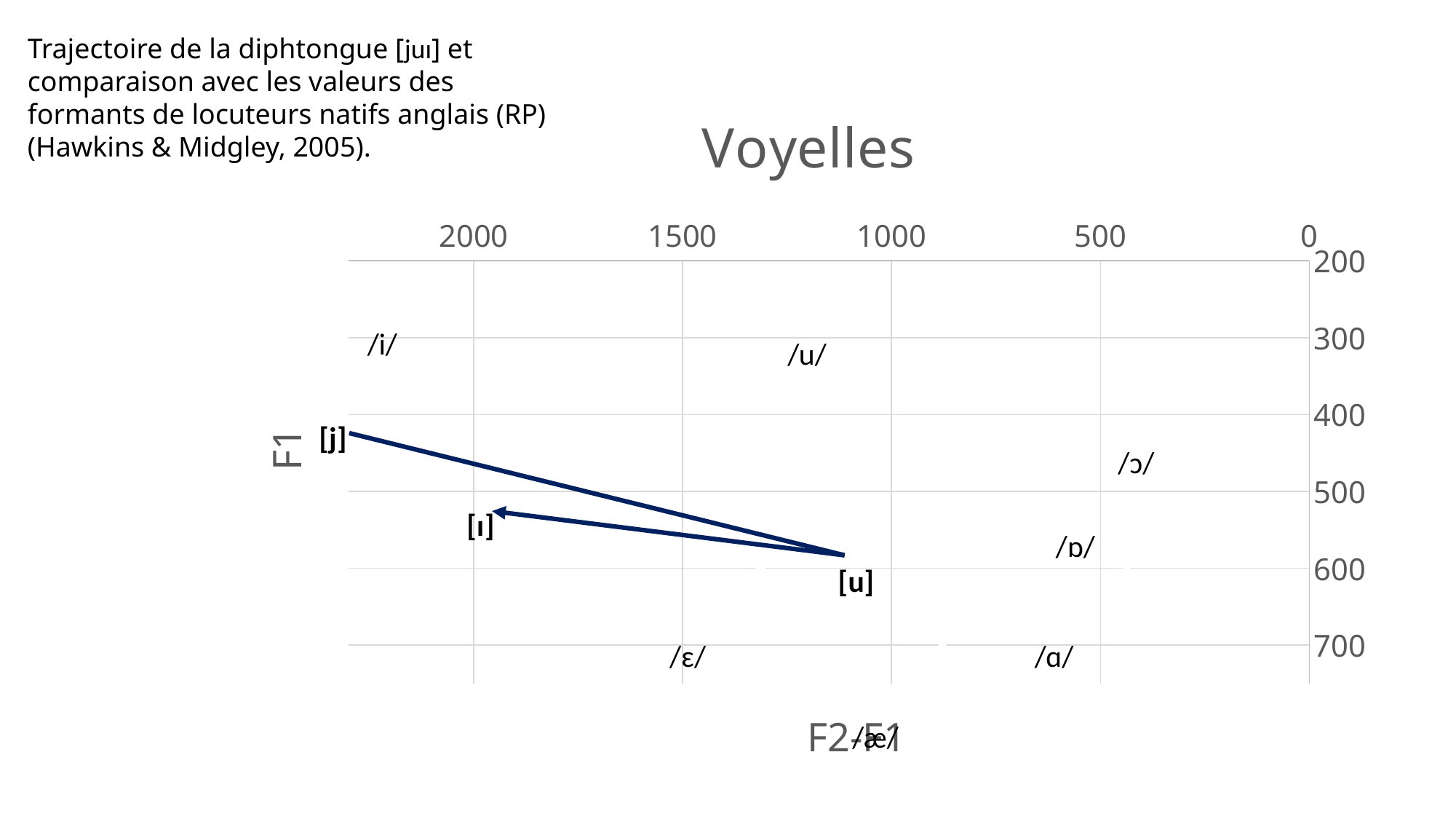
Is the F1 value for [j] greater or less than 300? greater Is the F2 value for [u] greater or less than 1500? less Is the F1 value for /ɛ/ greater or less than 600? greater Which has the higher F1 value, /i/ or /ɛ/? /ɛ/ What is the title of the chart? Voyelles Which has the higher F2 value, /i/ or /ɔ/? /i/ How many points make up the diphthong trajectory drawn with arrows on the chart? 3 Which of the labelled native vowels has the highest F1 value (lowest on the chart)? /æ/ What kind of chart is shown on the slide? scatter chart What is the title of the vertical axis of the chart? F1